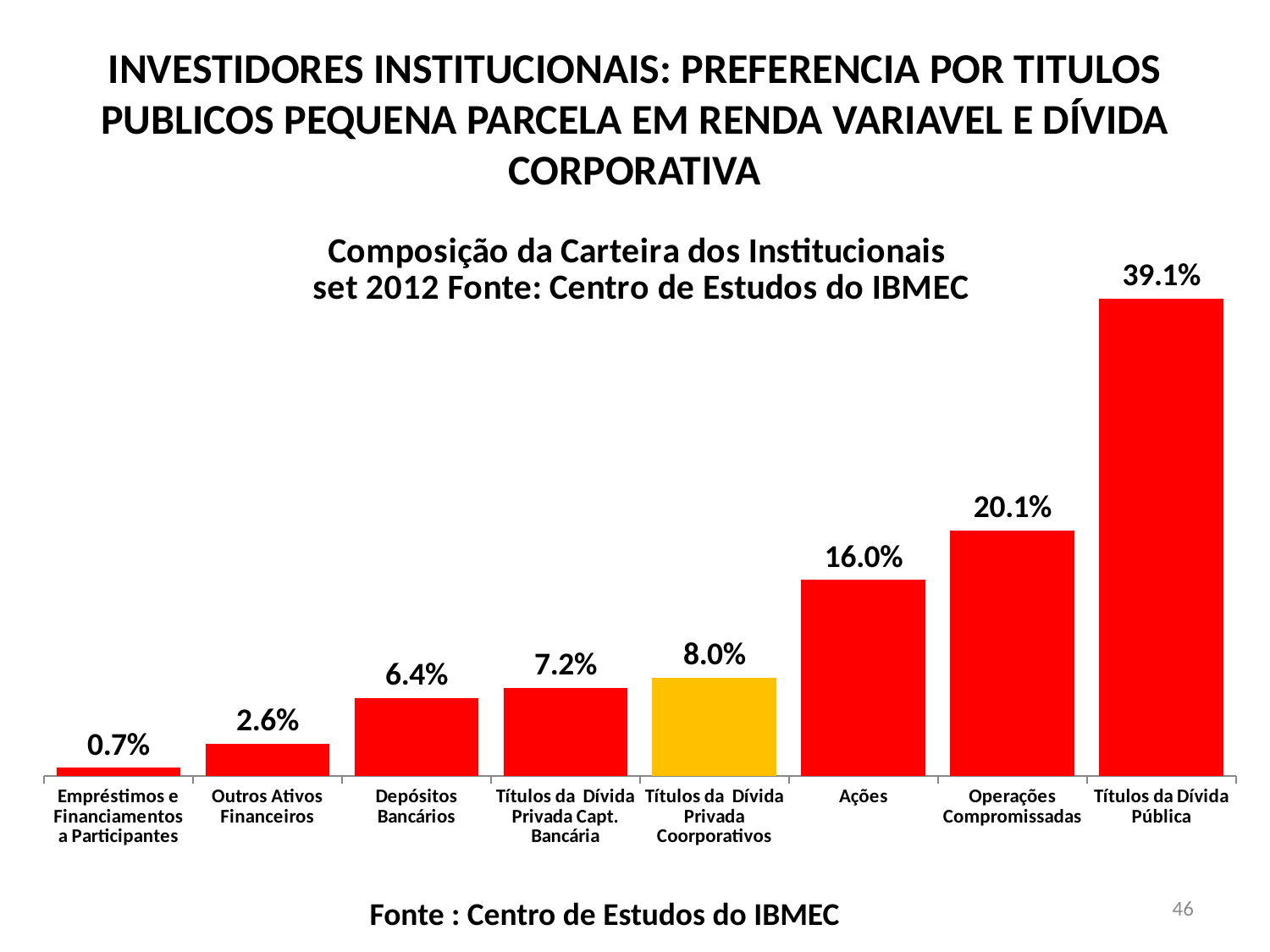
What is the value for Títulos da Dívida Privada Coorporativos? 8.0% Which is larger, Outros Ativos Financeiros or Depósitos Bancários? Depósitos Bancários Which category has the highest value? Títulos da Dívida Pública What is the value for Depósitos Bancários? 6.4% What kind of chart is shown on the slide? Bar chart What is the value for Ações? 16.0% Which bar is coloured differently (yellow) from the others? Títulos da Dívida Privada Coorporativos How many categories are shown in the chart? 8 What is the difference between Ações and Títulos da Dívida Privada Coorporativos? 8.0% Which category has the lowest value? Empréstimos e Financiamentos a Participantes What is the value for Títulos da Dívida Pública? 39.1% What is the difference between Títulos da Dívida Pública and Operações Compromissadas? 19.0%